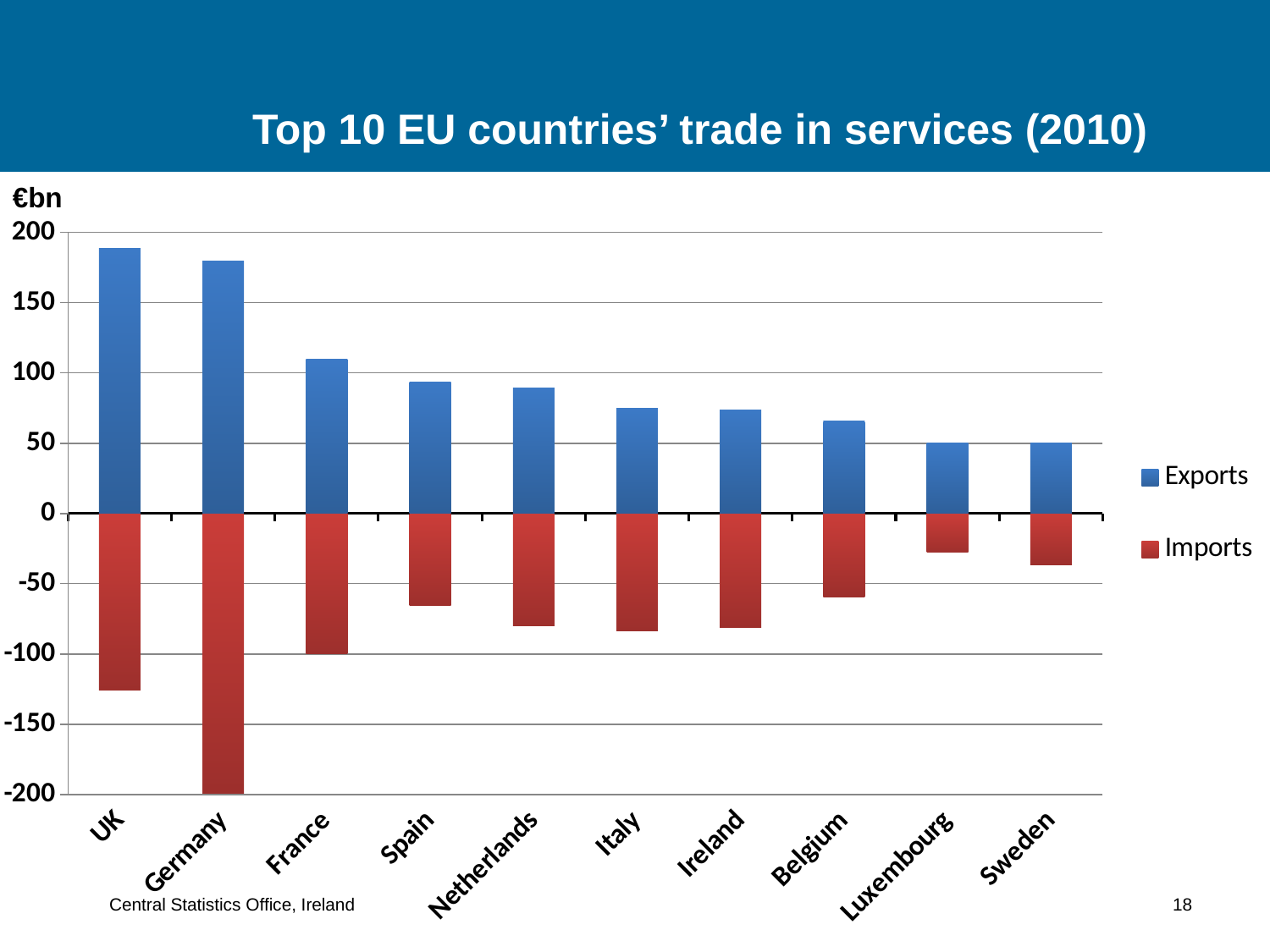
Which has the larger Imports bar, Luxembourg or Sweden? Sweden Which country has the largest Imports bar (the most negative value)? Germany How many series does the legend list? 2 Is the Exports value for Belgium greater or less than 50? greater Do the Exports values rise or fall moving from left to right along the x axis? fall What unit is shown on the y axis of the chart? €bn Is the Exports value for the UK greater or less than 150? greater How many countries are shown on the x axis? 10 Which country has the highest Exports value? UK What type of chart is shown on the slide? bar chart Is the Exports value for France greater or less than 100? greater Which has the larger Exports value, the UK or Germany? UK